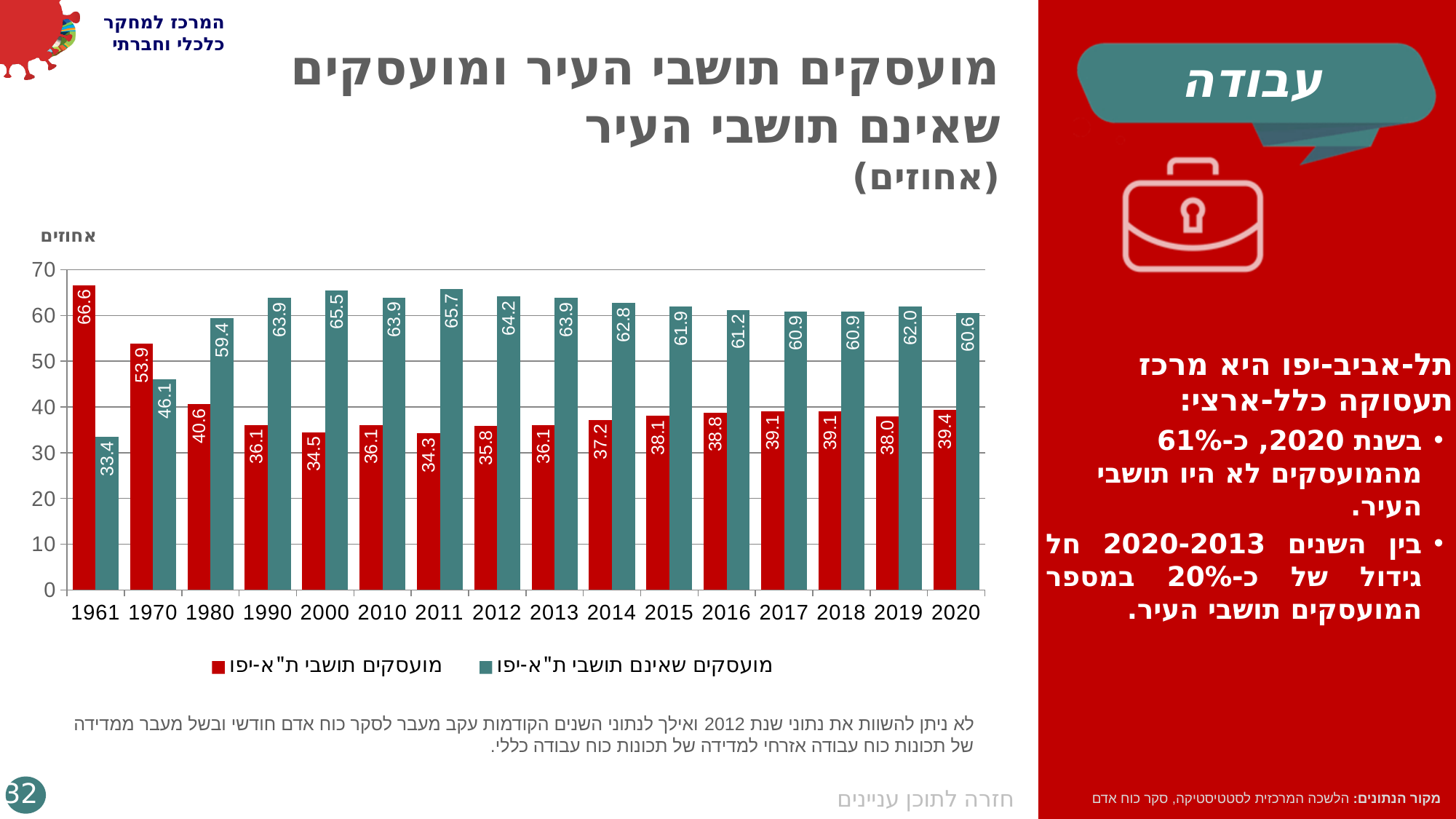
What is the label of the y axis of the chart? אחוזים How many series does the chart legend list? 2 How many years (categories) are shown on the x axis of the chart? 16 Does the red series (employed residents of Tel Aviv-Yafo) generally rise or fall from 1961 to 2000? Fall In which year is the red series (employed residents of Tel Aviv-Yafo) at its highest? 1961 What type of chart is shown on the slide? Bar chart Which series has the larger value in 1970: the red (residents) or the teal (non-residents)? Red (residents), 53.9 In which year is the red series (employed residents of Tel Aviv-Yafo) at its lowest? 2011 What is the value of the red series (מועסקים תושבי ת"א-יפו, employed residents of Tel Aviv-Yafo) in 2020? 39.4 In which year is the teal series (employed non-residents of Tel Aviv-Yafo) at its highest? 2011 What is the value of the teal series (מועסקים שאינם תושבי ת"א-יפו, employed non-residents) in 1961? 33.4 What is the difference between the teal and red values in 2020? 21.2